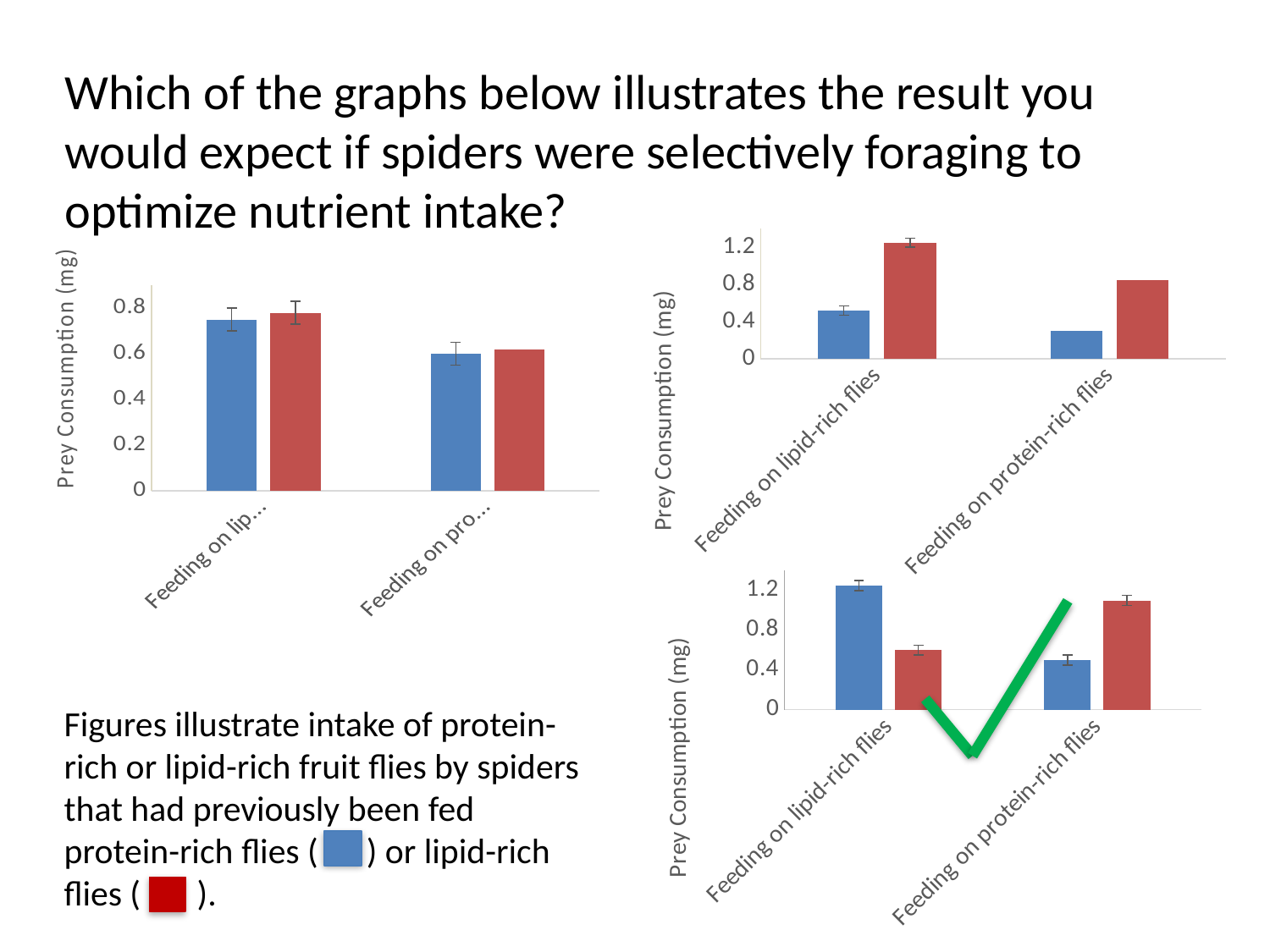
In the top-right chart, which bar is the highest? the red bar for Feeding on lipid-rich flies In the top-right chart, do the blue bars rise or fall from 'Feeding on lipid-rich flies' to 'Feeding on protein-rich flies'? fall In the top-right chart, is the red bar for 'Feeding on lipid-rich flies' greater or less than 0.8? greater What kind of chart is the chart on the left of the slide? bar chart In the left chart, is the blue bar for 'Feeding on lipid-rich flies' greater or less than 0.6? greater In the bottom-right chart, for 'Feeding on protein-rich flies', is the blue bar or the red bar larger? the red bar In the bottom-right chart, is the red bar for 'Feeding on protein-rich flies' greater or less than 0.8? greater In the top-right chart, how many categories are shown on the x axis? 2 Which of the three charts is marked with a green check mark? the bottom-right chart In the bottom-right chart, for 'Feeding on lipid-rich flies', is the blue bar or the red bar larger? the blue bar In the top-right chart, which bar is the lowest? the blue bar for Feeding on protein-rich flies